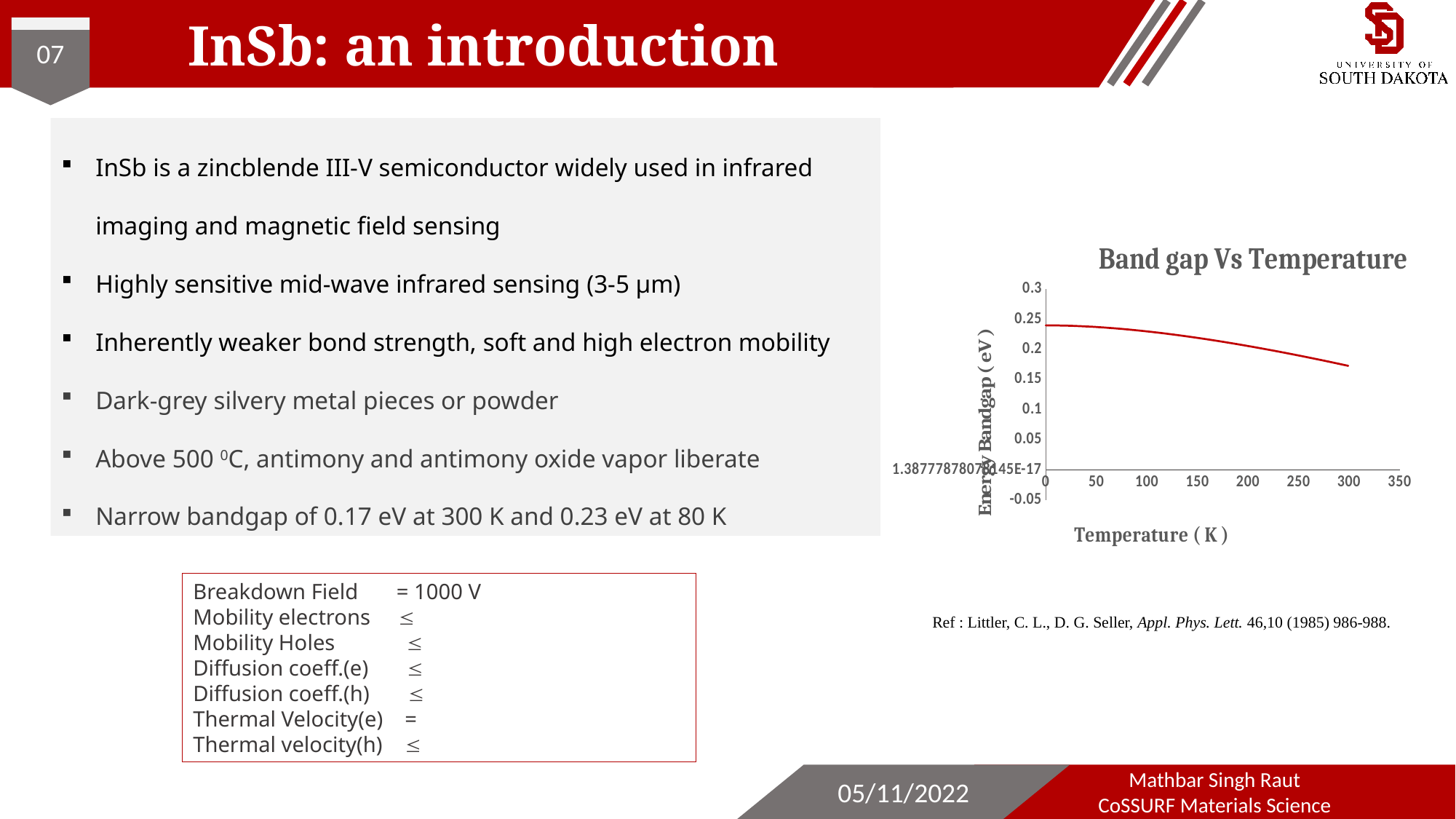
Which has the larger energy bandgap on the chart, 50 K or 300 K? 50 K Is the energy bandgap at 50 K greater or less than 0.3 eV? less What is the label of the x axis of the chart? Temperature ( K ) Does the energy bandgap rise or fall as temperature increases along the x axis? fall Is the energy bandgap at 0 K greater or less than 0.2 eV? greater How many lines are plotted on the chart? 1 What kind of chart is shown on the slide? line chart Is the energy bandgap at 300 K greater or less than 0.2 eV? less What is the title of the chart on the slide? Band gap Vs Temperature What is the highest tick value shown on the x axis of the chart? 350